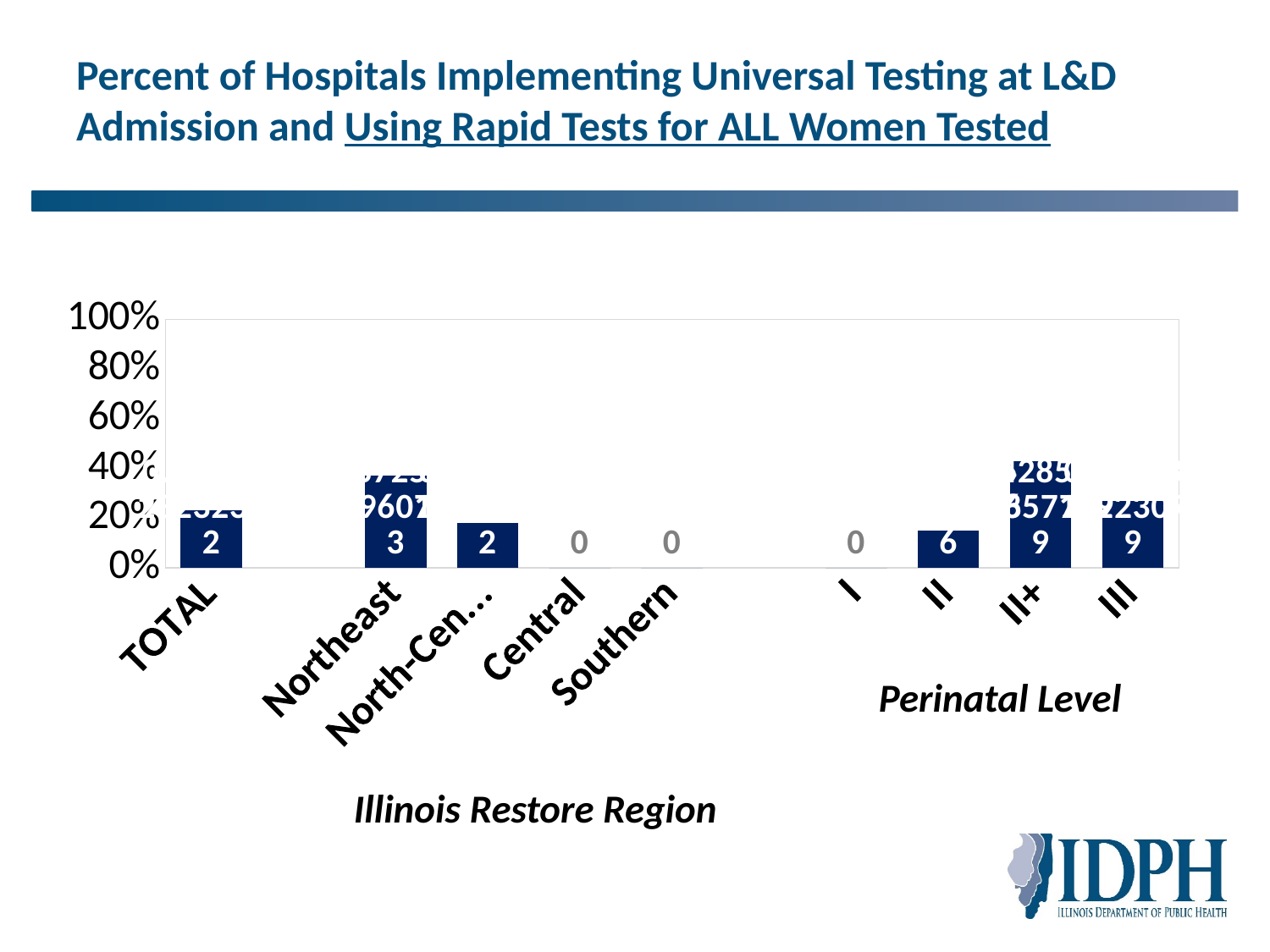
How many categories are shown along the x axis of the chart? 9 What are the two group labels shown beneath the x axis of the chart? Illinois Restore Region and Perinatal Level Which bar is taller, Northeast or North-Central? Northeast Is the value for Northeast greater or less than 20%? greater What number is printed for the Central category? 0 Is the value for TOTAL greater or less than 40%? less Which bar is taller, perinatal level II or perinatal level II+? II+ What kind of chart is shown on the slide? bar chart